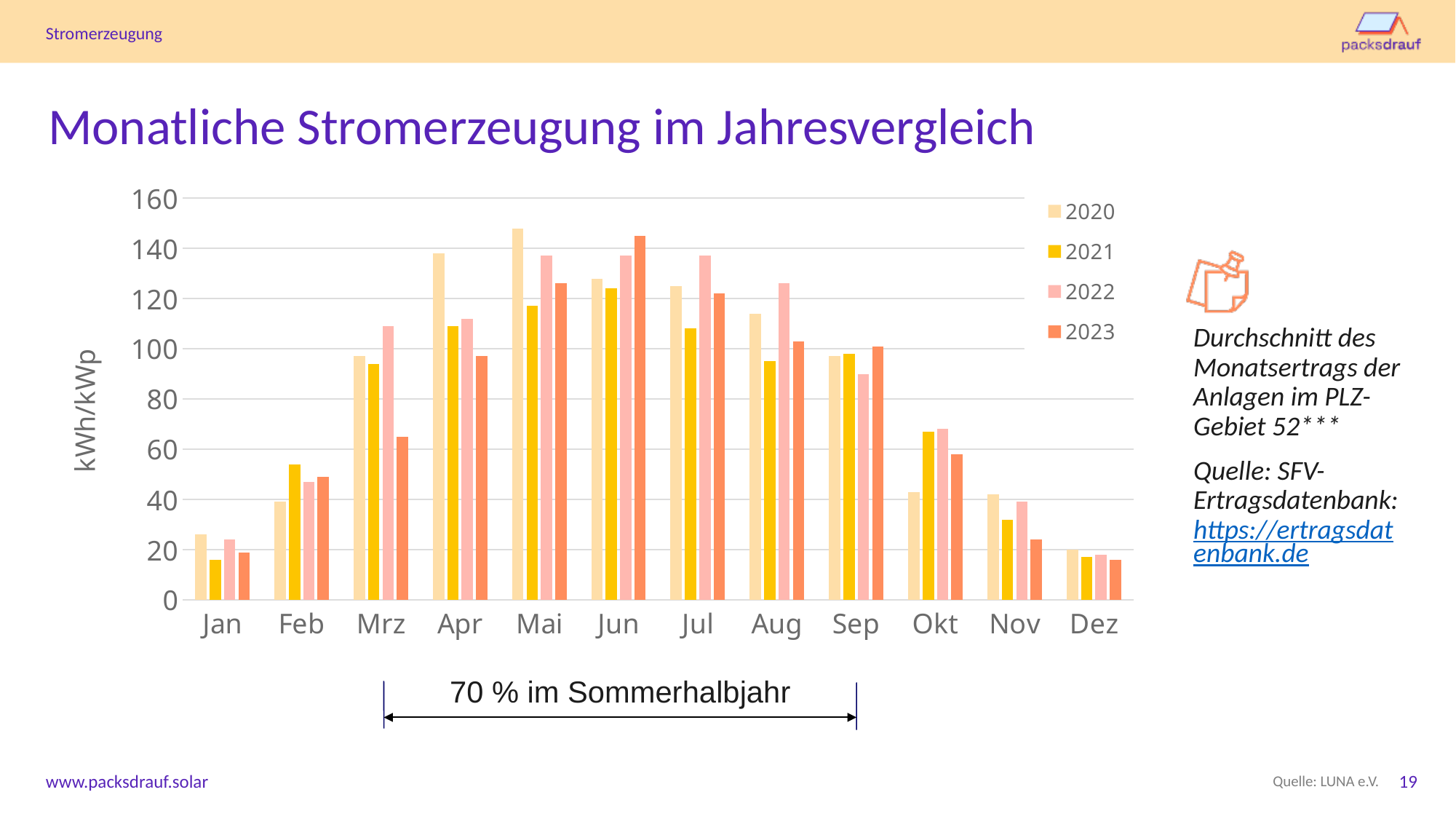
Is the value for 2023 in Mrz greater or less than 80? less How many months are shown along the x axis? 12 In which month is the 2020 value lowest? Dez How many series does the legend list? 4 In Jun, which is larger: the value for 2023 or the value for 2021? 2023 What is the label on the y axis? kWh/kWp In Apr, which is larger: the value for 2020 or the value for 2023? 2020 Is the value for 2020 in Mai greater or less than 140? greater What kind of chart is shown on the slide? bar chart Do the 2020 values rise or fall from Jan to Mai? rise What does the annotation below the x axis say about the summer half-year? 70 % im Sommerhalbjahr In which month is the 2020 value highest? Mai